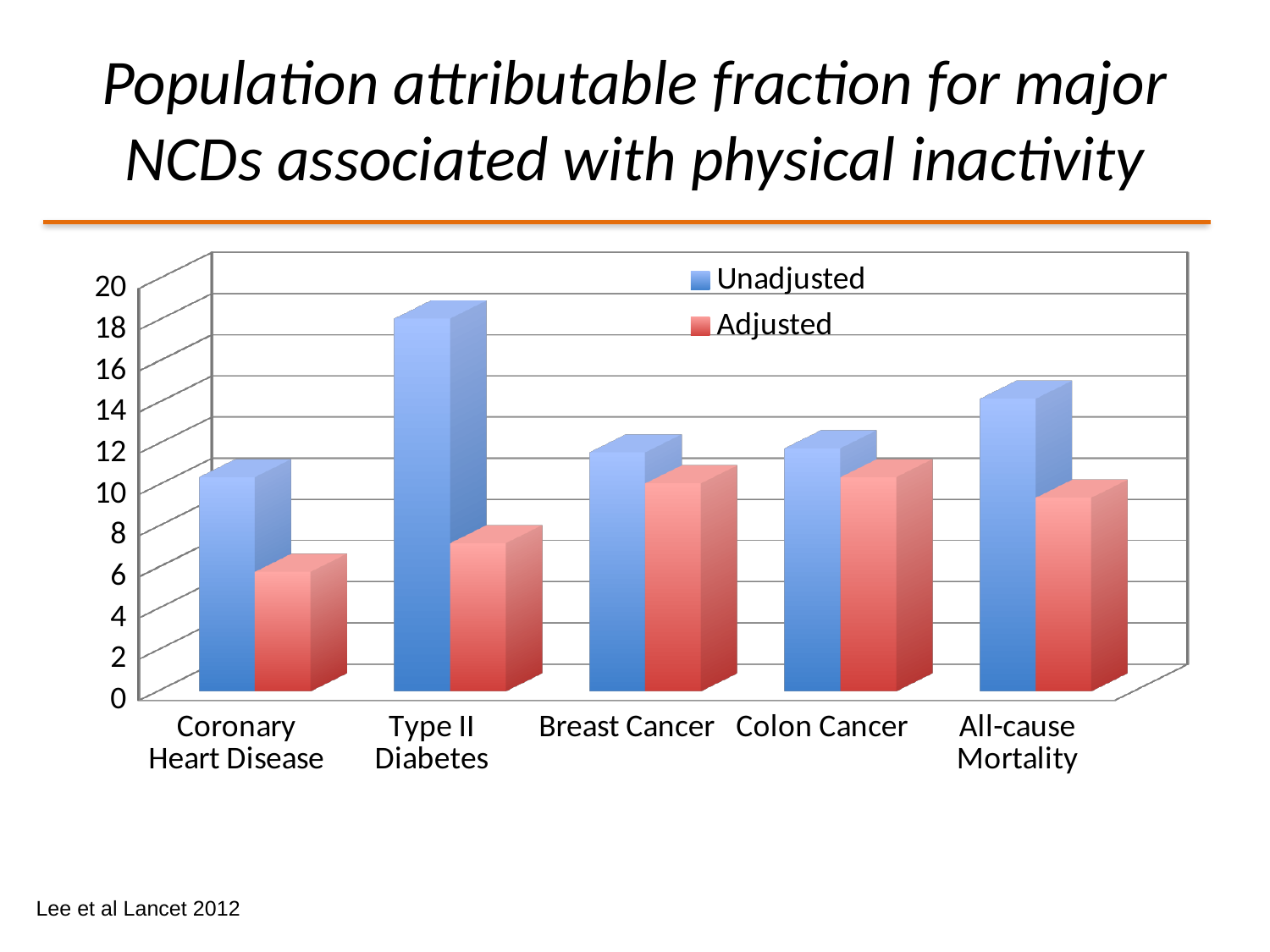
For Type II Diabetes, which is larger: the Unadjusted or the Adjusted value? Unadjusted Which category has the lowest Adjusted value? Coronary Heart Disease Is the Unadjusted value for Type II Diabetes greater or less than 16? greater Is the Unadjusted value for All-cause Mortality greater or less than 12? greater Which category has the highest Unadjusted value? Type II Diabetes What are the two series named in the legend? Unadjusted and Adjusted How many categories are shown on the x axis? 5 How many series does the legend list? 2 Is the Adjusted value for Coronary Heart Disease greater or less than 8? less Which is larger: the Unadjusted value for Type II Diabetes or the Unadjusted value for All-cause Mortality? Type II Diabetes What kind of chart is shown on the slide? bar chart